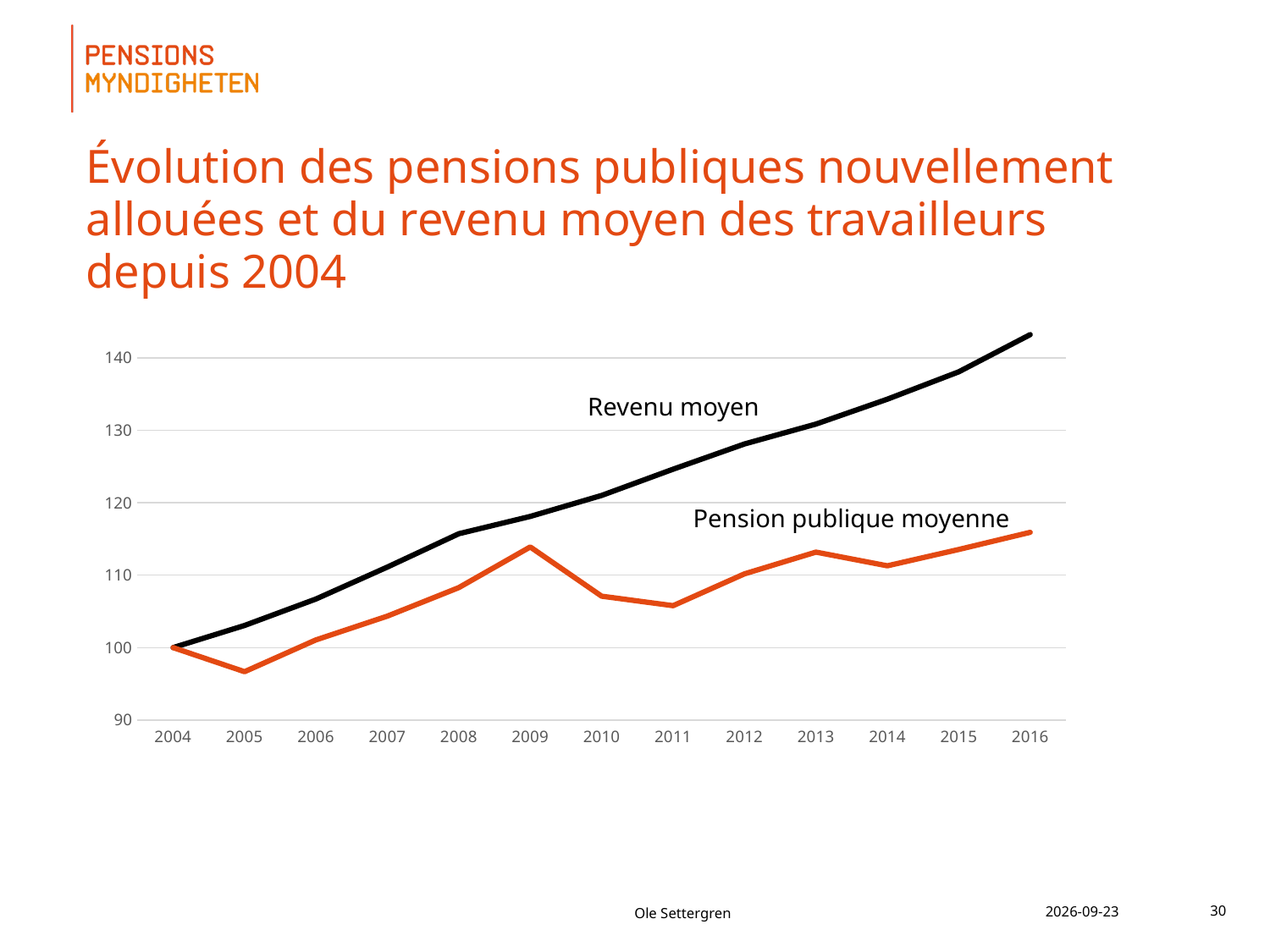
Is the value for Pension publique moyenne in 2016 greater or less than 110? greater Is the value for Revenu moyen in 2016 greater or less than 140? greater Is the value for Revenu moyen in 2012 greater or less than 130? less What kind of chart is shown on the slide? line chart What is the value of Pension publique moyenne in 2004? 100 How many years are shown on the x axis of the chart? 13 How many series are plotted on the chart? 2 What is the value of Revenu moyen in 2004? 100 Which series has the higher value in 2010, Revenu moyen or Pension publique moyenne? Revenu moyen Does Revenu moyen rise or fall from 2004 to 2016? rise In which year is Pension publique moyenne at its lowest? 2005